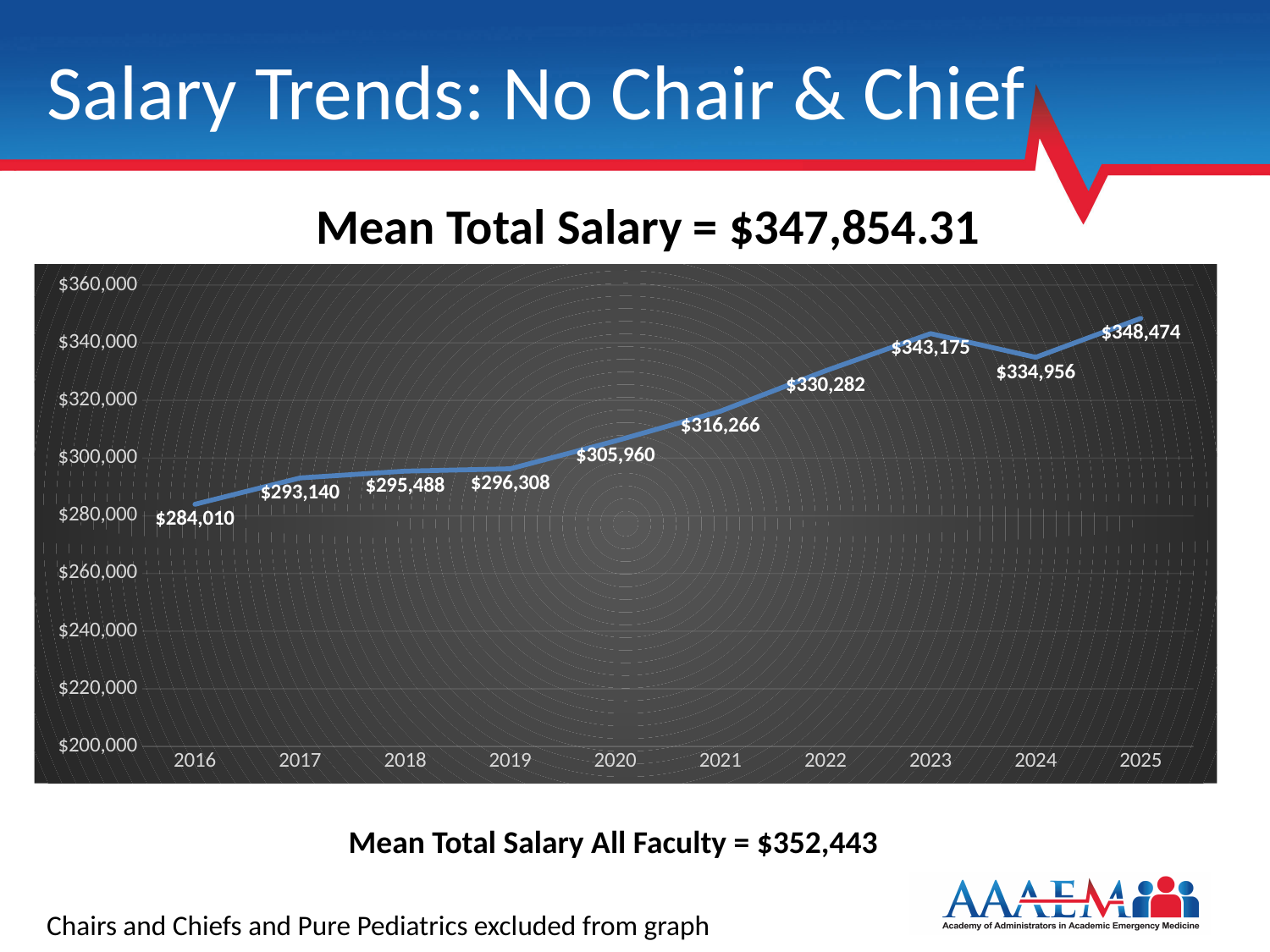
What is the mean total salary shown for 2016? $284,010 Which is larger, the value for 2023 or the value for 2024? 2023 What is the mean total salary shown for 2020? $305,960 Which year has the highest mean total salary on the chart? 2025 What is the difference between the 2025 value and the 2016 value? $64,464 How many years are plotted on the chart? 10 Is the value for 2021 greater or less than $320,000? less What is the mean total salary shown for 2024? $334,956 Which year has the lowest mean total salary on the chart? 2016 By how much did the value drop from 2023 to 2024? $8,219 What kind of chart is shown on the slide? line chart What is the overall trend of the values from 2016 to 2025? rising